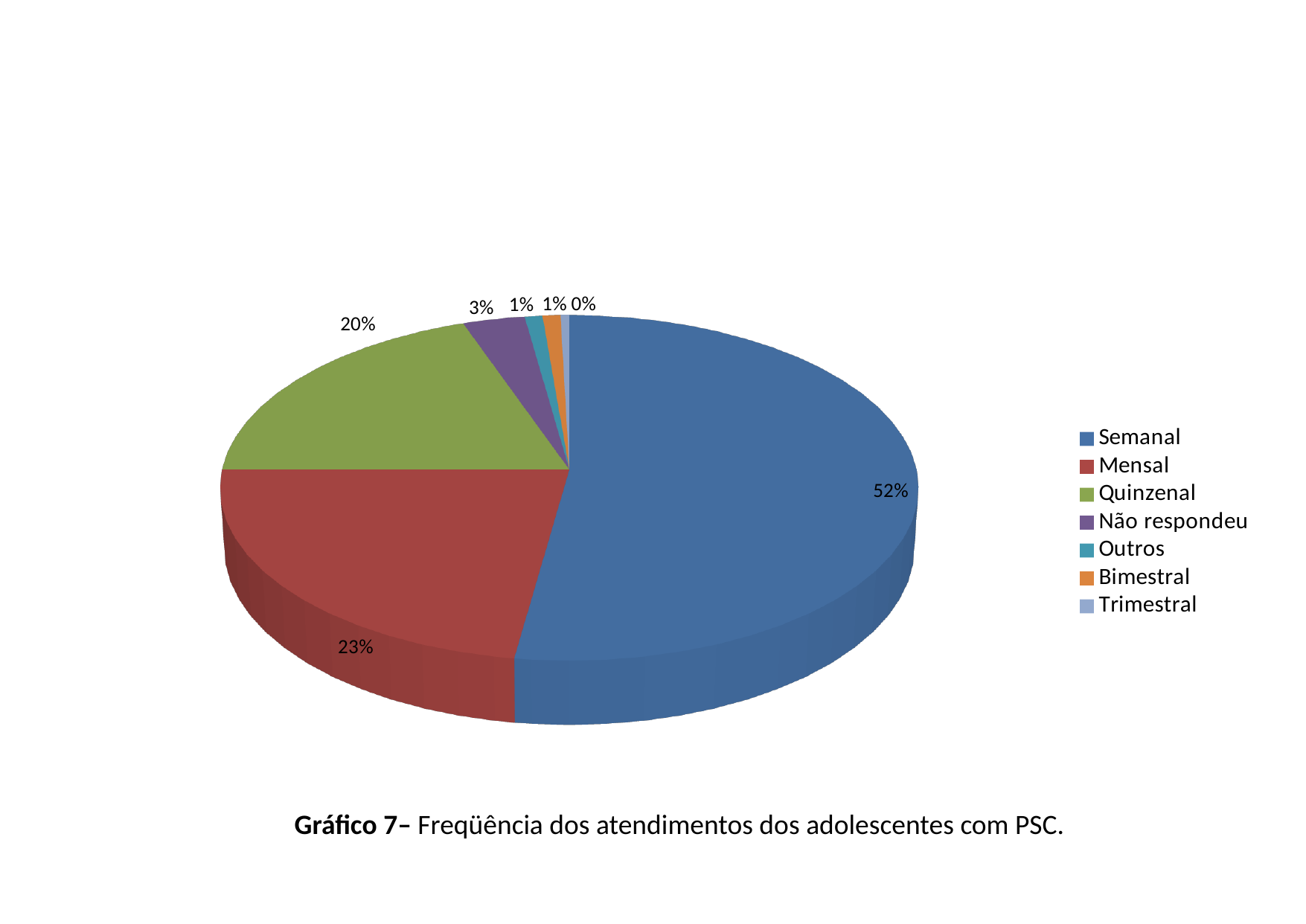
What share of the pie does Semanal represent? 52% What share of the pie does Não respondeu represent? 3% What kind of chart is shown on the slide? pie chart Which category has the largest slice of the pie? Semanal Which category has the smallest slice of the pie? Trimestral What is the difference between the Semanal and Mensal shares? 29% What is the caption of the chart? Gráfico 7– Freqüência dos atendimentos dos adolescentes com PSC. Which is larger, the Mensal share or the Quinzenal share? Mensal What share of the pie does Trimestral represent? 0% How many categories does the legend list? 7